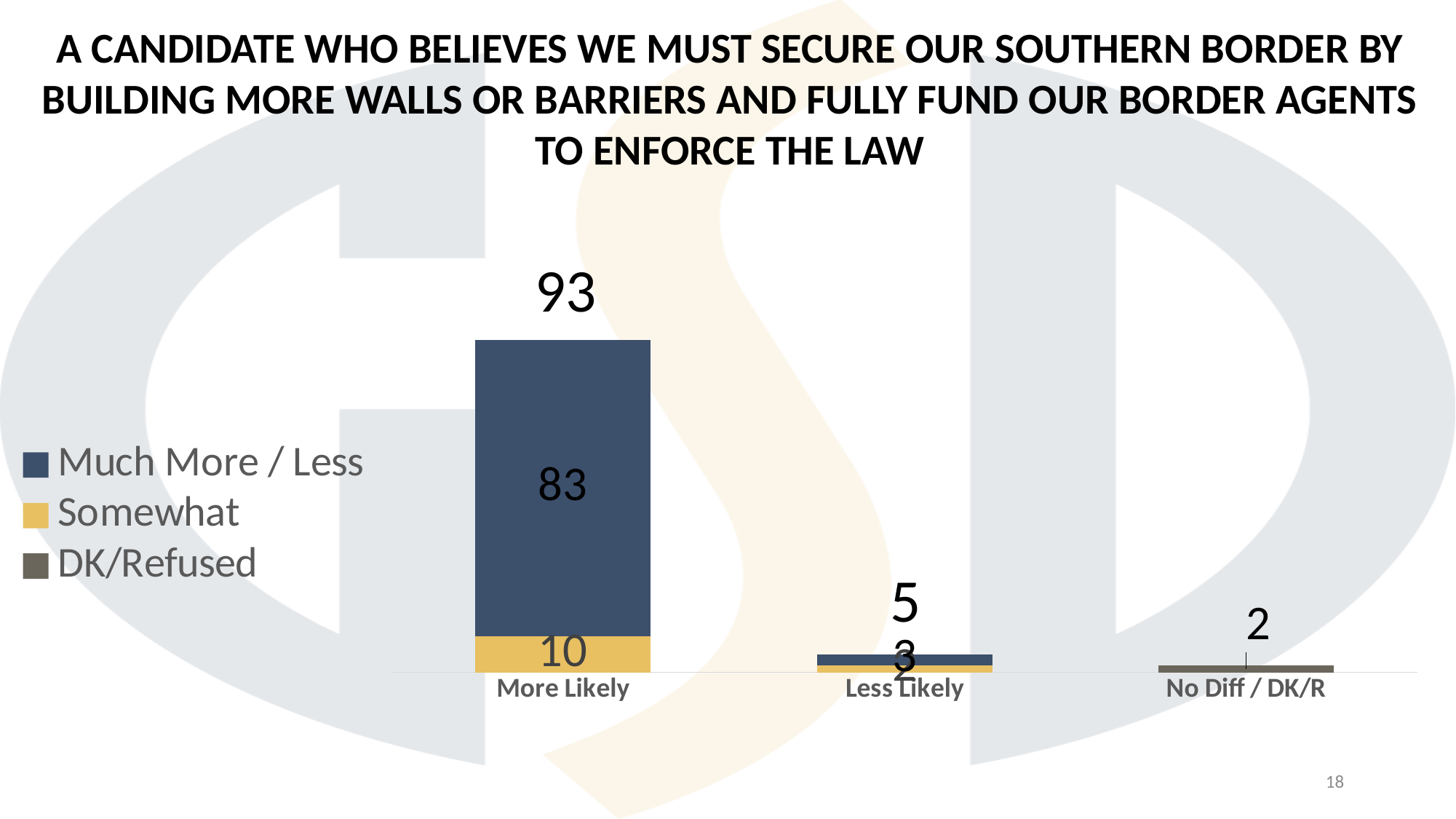
How many categories are shown on the x axis? 3 Which legend entry is shown in gold/yellow? Somewhat What is the difference between the More Likely total and the Less Likely total? 88 How many series does the legend list? 3 Which category has the highest total? More Likely Which category has the lowest total? No Diff / DK/R What is the Somewhat value for More Likely? 10 What is the value for No Diff / DK/R? 2 What is the Much More / Less value for More Likely? 83 What is the total of the stacked bar for Less Likely? 5 What type of chart is shown on the slide? bar chart What is the total of the stacked bar for More Likely? 93